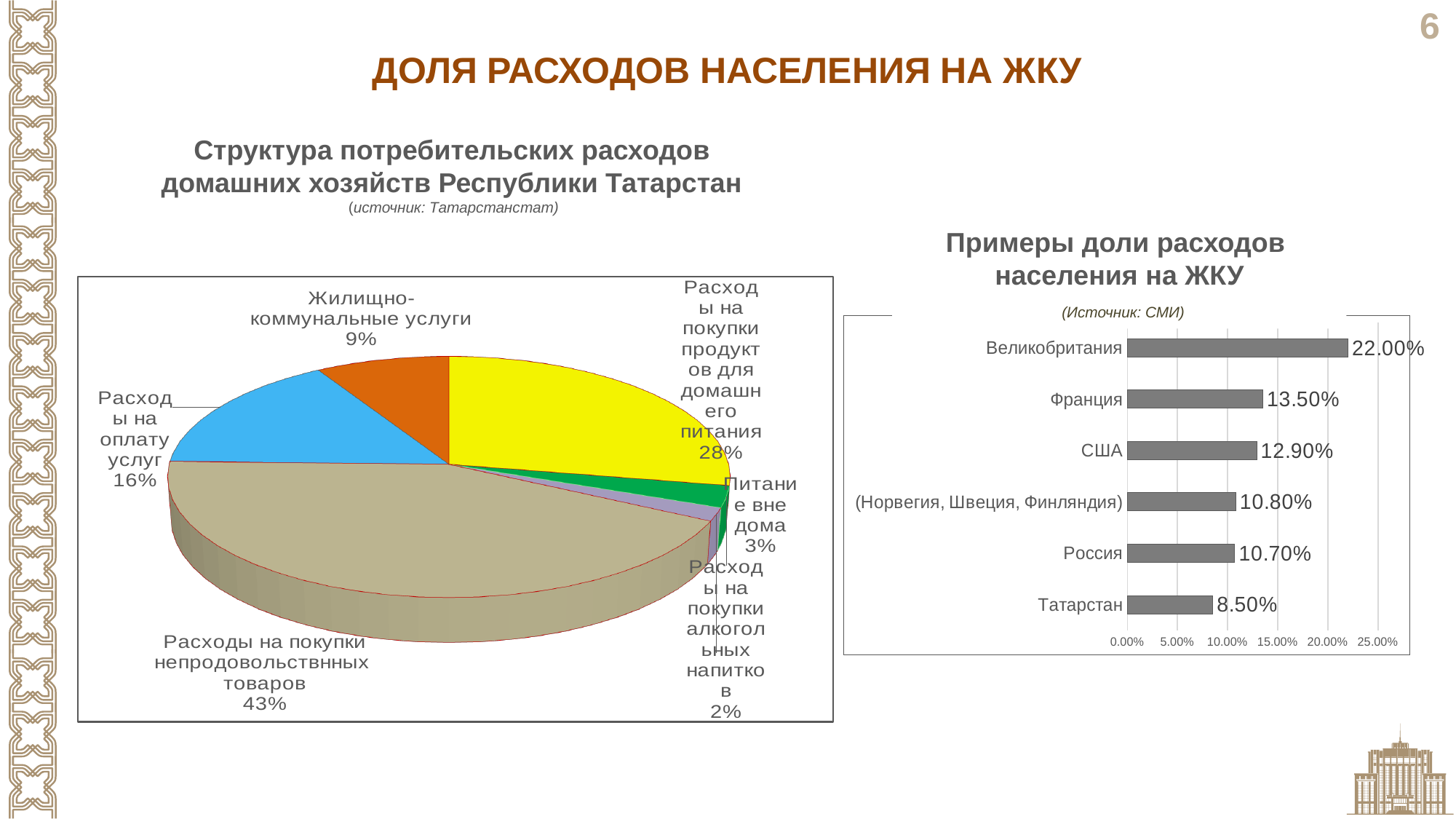
In the chart titled 'Примеры доли расходов населения на ЖКУ', what kind of chart is used? Bar chart In the chart titled 'Примеры доли расходов населения на ЖКУ', what is the difference between the values for Великобритания and Россия? 11.30% In the pie chart on the left, what share is labelled for Жилищно-коммунальные услуги? 9% In the chart titled 'Примеры доли расходов населения на ЖКУ', how many categories are shown? 6 In the pie chart on the left, which category has the largest share? Расходы на покупки непродовольственных товаров In the chart titled 'Примеры доли расходов населения на ЖКУ', which country has the highest value? Великобритания In the chart titled 'Примеры доли расходов населения на ЖКУ', what is the value for Татарстан? 8.50% In the pie chart on the left, which category has the smallest share? Расходы на покупки алкогольных напитков In the pie chart on the left, how many slices are there? 6 In the pie chart on the left, what share is labelled for Расходы на покупки непродовольственных товаров? 43% In the pie chart on the left, what is the difference between the share for Расходы на покупки продуктов для домашнего питания and the share for Расходы на оплату услуг? 12% In the chart titled 'Примеры доли расходов населения на ЖКУ', what is the value for Франция? 13.50%